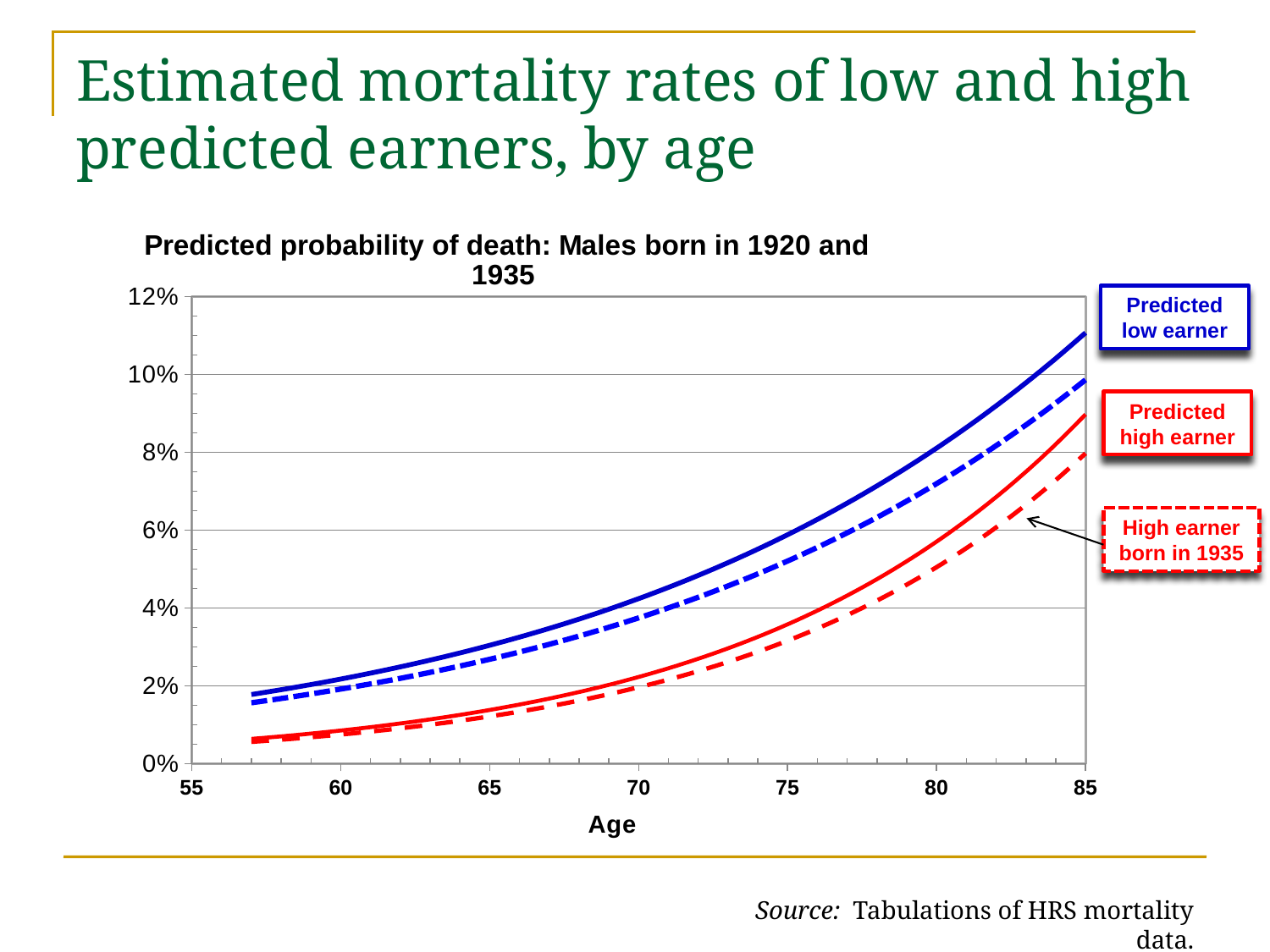
At age 80, is the solid blue predicted low earner line greater or less than 6%? greater What is the title of the chart? Predicted probability of death: Males born in 1920 and 1935 What kind of chart is shown on the slide? line chart How many lines are plotted on the chart? 4 What is the label of the x axis? Age At age 60, is the solid red predicted high earner line greater or less than 2%? less At age 85, is the solid blue predicted low earner line greater or less than 10%? greater Do the predicted probabilities of death rise or fall as age increases? rise At age 85, which is higher: the solid predicted low earner line or the solid predicted high earner line? Predicted low earner